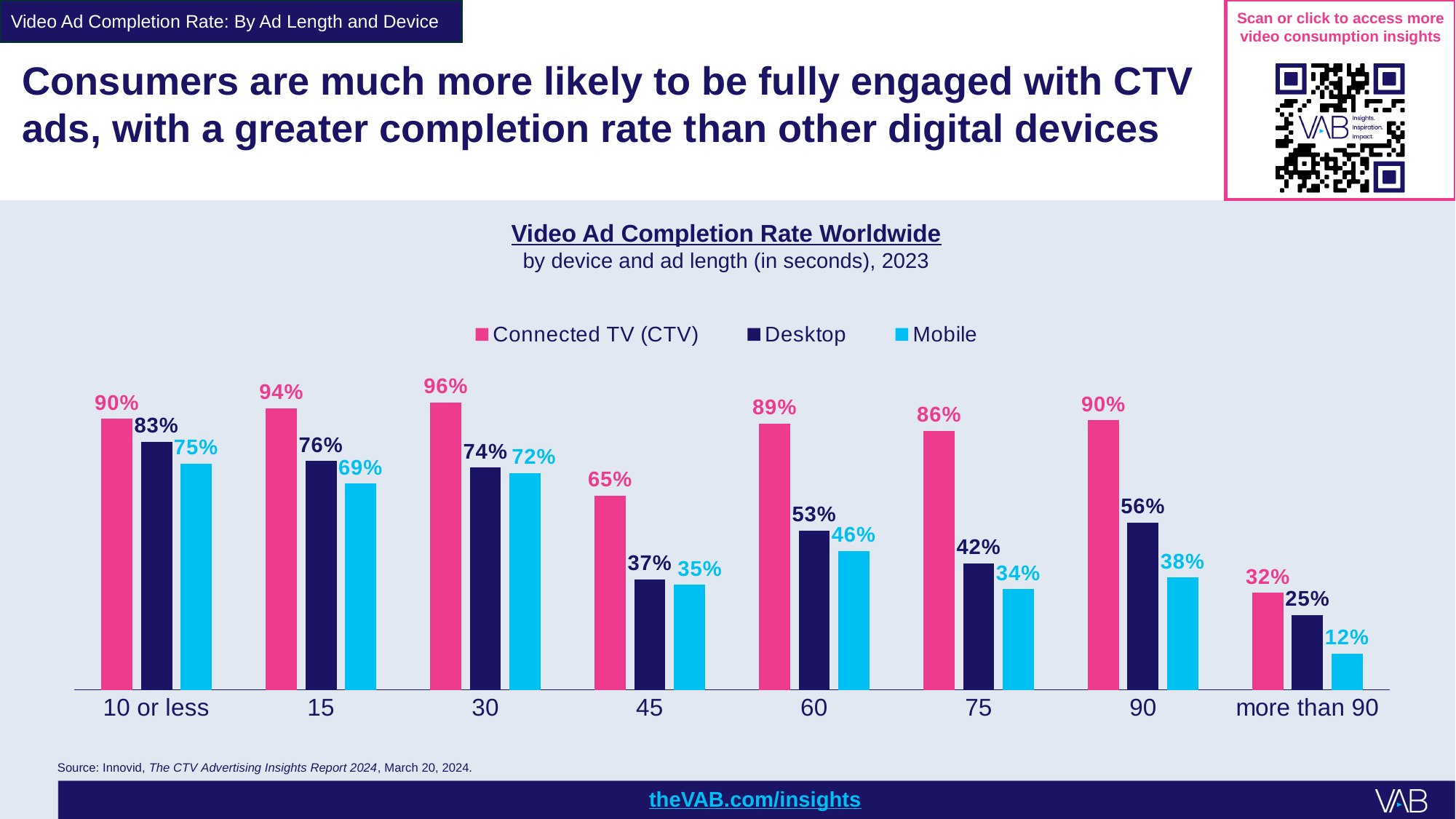
Which ad length has the highest Connected TV (CTV) completion rate? 30 What is the Desktop completion rate for 60-second ads? 53% What kind of chart is shown on the slide? Bar chart Which is higher for 15-second ads: the Desktop rate or the Mobile rate? Desktop Which colour represents Connected TV (CTV) in the chart? Pink What is the Mobile completion rate for ads of more than 90 seconds? 12% How many series does the legend list? 3 How many ad length categories are shown on the x axis? 8 Which ad length has the lowest Desktop completion rate? more than 90 What is the difference between the CTV and Mobile completion rates for 45-second ads? 30% What is the Connected TV (CTV) completion rate for ads of 30 seconds? 96% Does the Mobile completion rate rise or fall from 30 seconds to 45 seconds? Fall